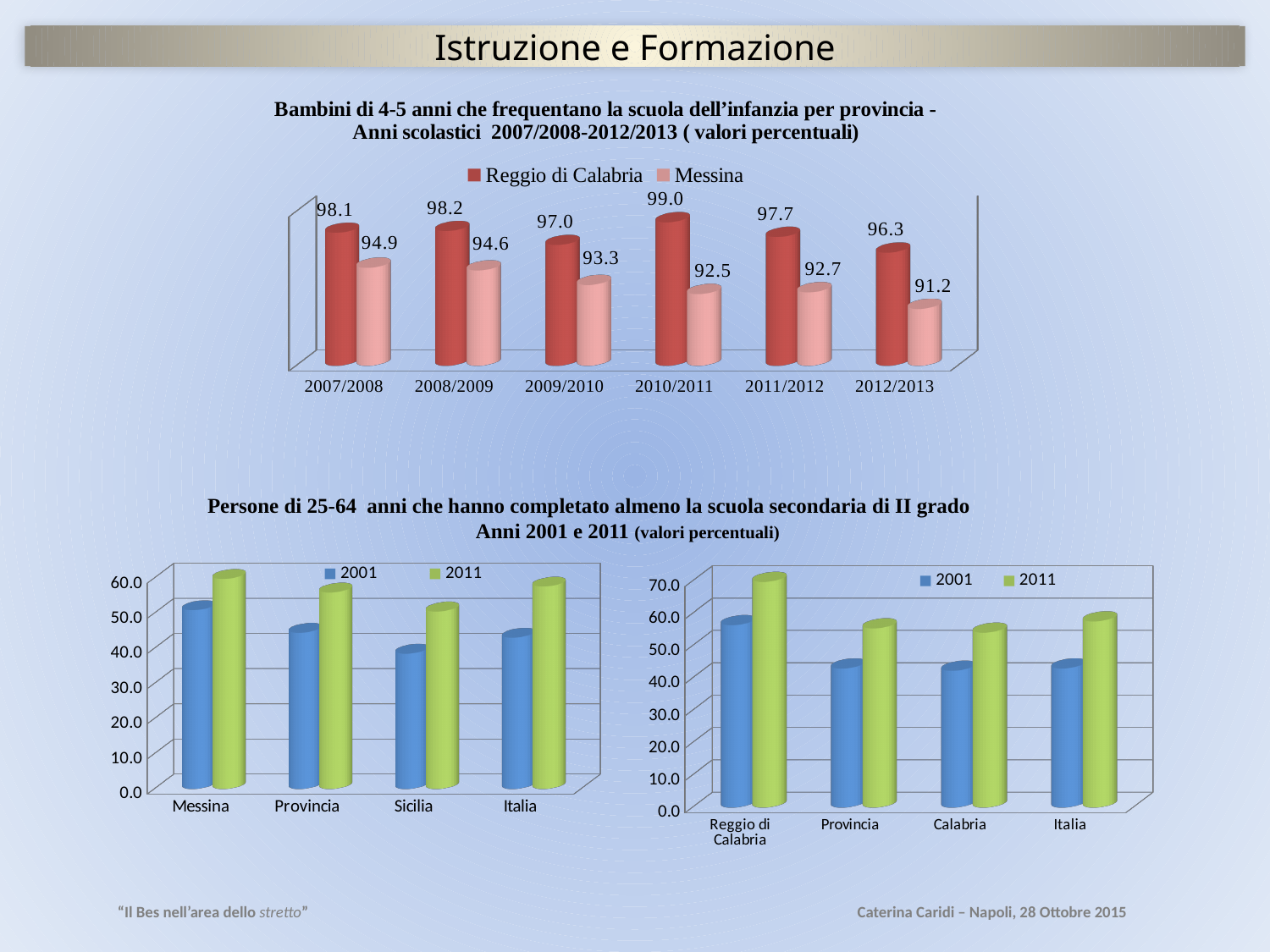
In the top chart (Bambini di 4-5 anni), what is the value for Messina in 2012/2013? 91.2 In the bottom-right chart (Persone di 25-64 anni, Reggio di Calabria/Provincia/Calabria/Italia), is the 2011 value for Reggio di Calabria greater or less than 60.0? greater In the top chart (Bambini di 4-5 anni), in which school year is the Reggio di Calabria value lowest? 2012/2013 In the bottom-right chart (Persone di 25-64 anni, Reggio di Calabria/Provincia/Calabria/Italia), which is larger: the 2001 value for Reggio di Calabria or the 2001 value for Provincia? Reggio di Calabria In the top chart (Bambini di 4-5 anni che frequentano la scuola dell'infanzia), what is the value for Reggio di Calabria in 2010/2011? 99.0 How many series does the legend of the bottom-right chart list? 2 In the top chart (Bambini di 4-5 anni), how many school years are shown on the x axis? 6 In the top chart (Bambini di 4-5 anni), does the Messina series generally rise or fall from 2007/2008 to 2012/2013? fall In the top chart (Bambini di 4-5 anni), in which school year is the Messina value highest? 2007/2008 In the bottom-left chart (Persone di 25-64 anni, Messina/Provincia/Sicilia/Italia), which category has the highest 2011 value? Messina In the top chart (Bambini di 4-5 anni), what is the difference between Reggio di Calabria and Messina in 2010/2011? 6.5